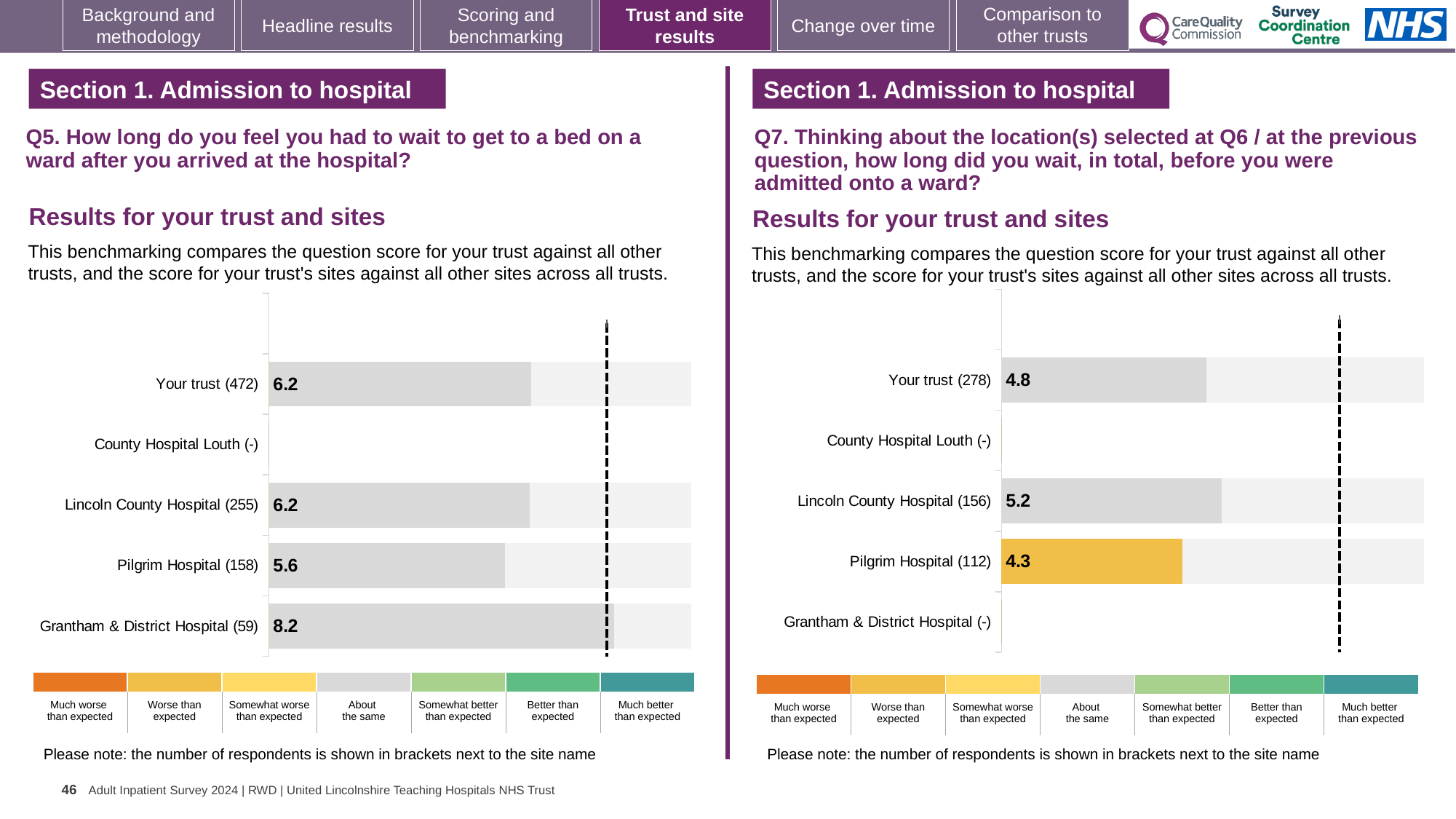
In the Q7 chart on the right, what is the difference between the scores for Lincoln County Hospital and Your trust? 0.4 What type of chart is used for the Q7 results on the right? Bar chart In the Q7 chart on the right, what is the score for Pilgrim Hospital? 4.3 In the Q5 chart on the left, what is the difference between the scores for Grantham & District Hospital and Pilgrim Hospital? 2.6 In the Q5 chart on the left, what is the score for Grantham & District Hospital? 8.2 How many rows (trust and sites) are listed in the Q5 chart on the left? 5 In the Q7 chart on the right, which site has the lowest score? Pilgrim Hospital In the Q7 chart on the right, is the score for Your trust larger or smaller than the score for Lincoln County Hospital? smaller In the Q5 chart on the left, which site has the lowest score? Pilgrim Hospital In the Q5 chart on the left, which site has the highest score? Grantham & District Hospital In the Q5 chart on the left, what is the score for Your trust? 6.2 In the Q7 chart on the right, what is the score for Lincoln County Hospital? 5.2